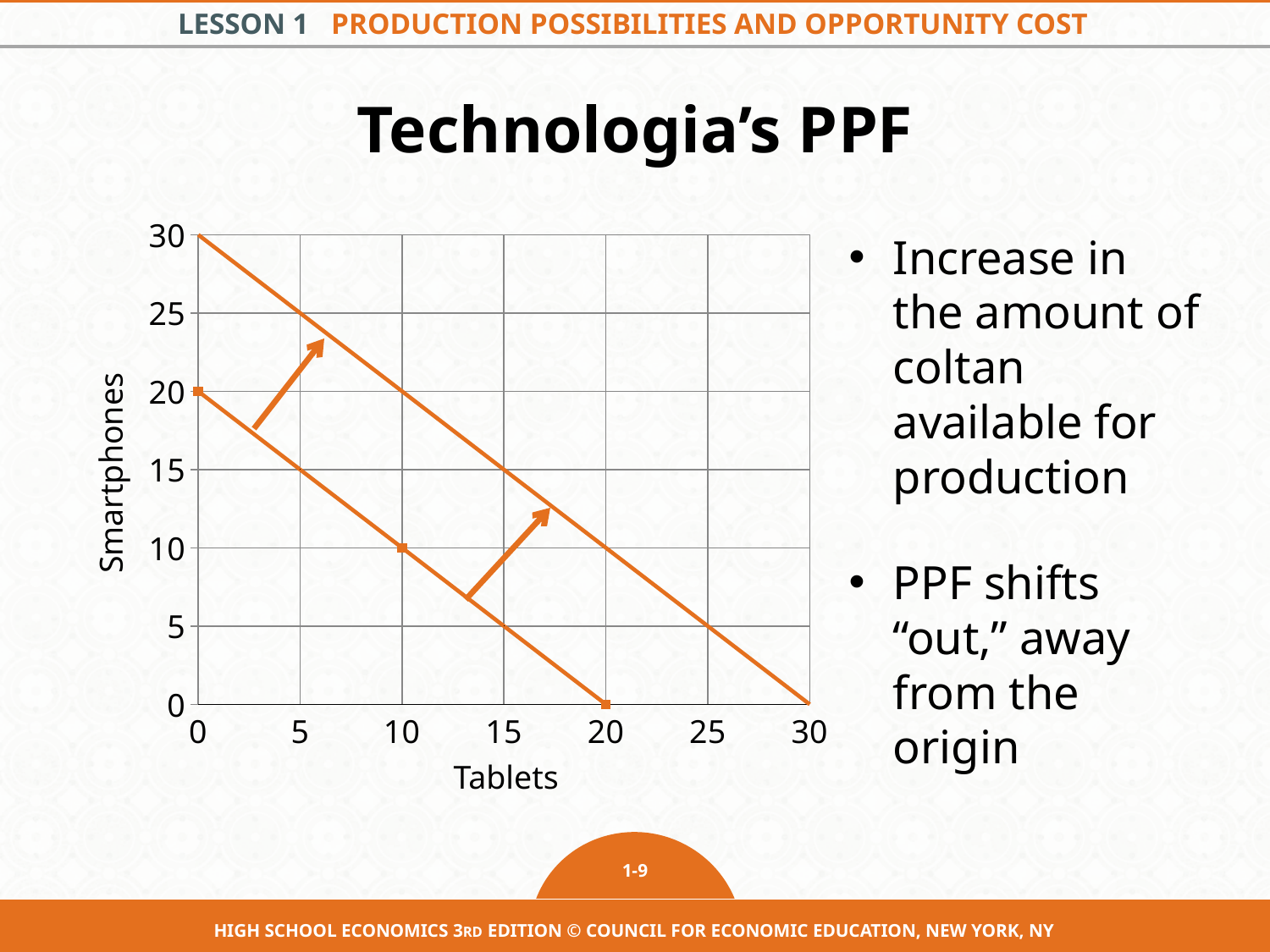
What is the label of the x axis? Tablets On the inner (original) PPF line, how many smartphones are produced when 10 tablets are produced? 10 On the outer (shifted) PPF line, how many smartphones are produced when 0 tablets are produced? 30 On the inner (original) PPF line, how many smartphones are produced when 0 tablets are produced? 20 How many PPF lines are plotted on the chart? 2 On the outer (shifted) PPF line, how many tablets are produced when 0 smartphones are produced? 30 What is the label of the y axis? Smartphones Along the x axis, do the smartphone values on each PPF line rise or fall as the number of tablets increases? fall By how much does the smartphone intercept (at 0 tablets) increase from the inner PPF line to the outer PPF line? 10 What kind of chart is shown on the slide? line chart On the outer (shifted) PPF line, is the number of smartphones at 10 tablets greater or less than 15? greater On the inner (original) PPF line, how many tablets are produced when 0 smartphones are produced? 20